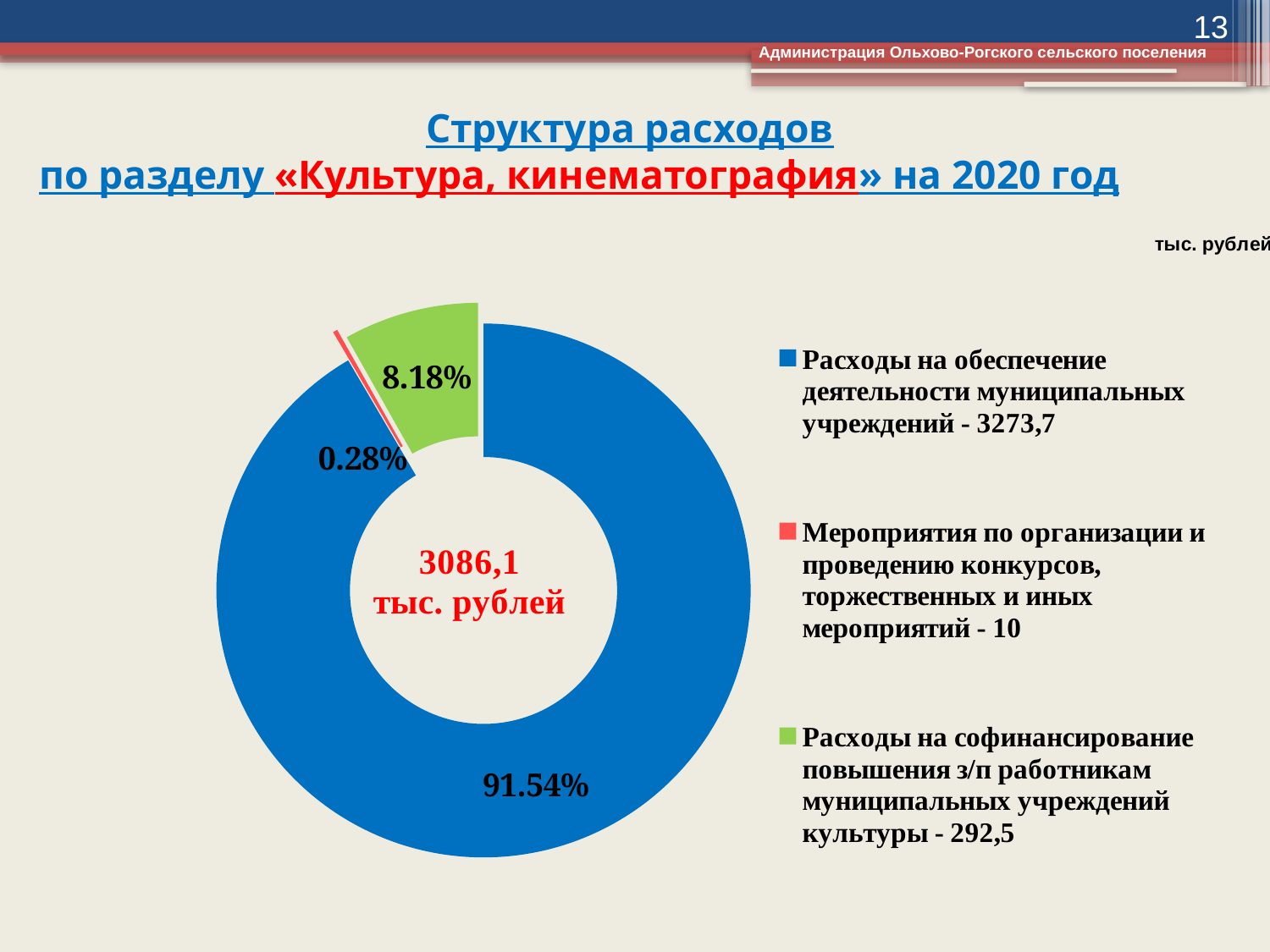
Which category has the smallest slice of the doughnut chart? Мероприятия по организации и проведению конкурсов, торжественных и иных мероприятий What value is given in the legend for «Расходы на софинансирование повышения з/п работникам муниципальных учреждений культуры»? 292,5 What share of the chart is labelled for «Расходы на софинансирование повышения з/п работникам муниципальных учреждений культуры»? 8.18% What total amount is printed in the centre of the doughnut chart? 3086,1 тыс. рублей Which category has the largest slice of the doughnut chart? Расходы на обеспечение деятельности муниципальных учреждений What share of the chart is labelled for «Мероприятия по организации и проведению конкурсов, торжественных и иных мероприятий»? 0.28% How many slices does the doughnut chart have? 3 How many entries does the legend list? 3 What share of the chart is labelled for «Расходы на обеспечение деятельности муниципальных учреждений»? 91.54% What value is given in the legend for «Мероприятия по организации и проведению конкурсов, торжественных и иных мероприятий»? 10 What value is given in the legend for «Расходы на обеспечение деятельности муниципальных учреждений»? 3273,7 What kind of chart is shown on the slide? Doughnut (pie) chart